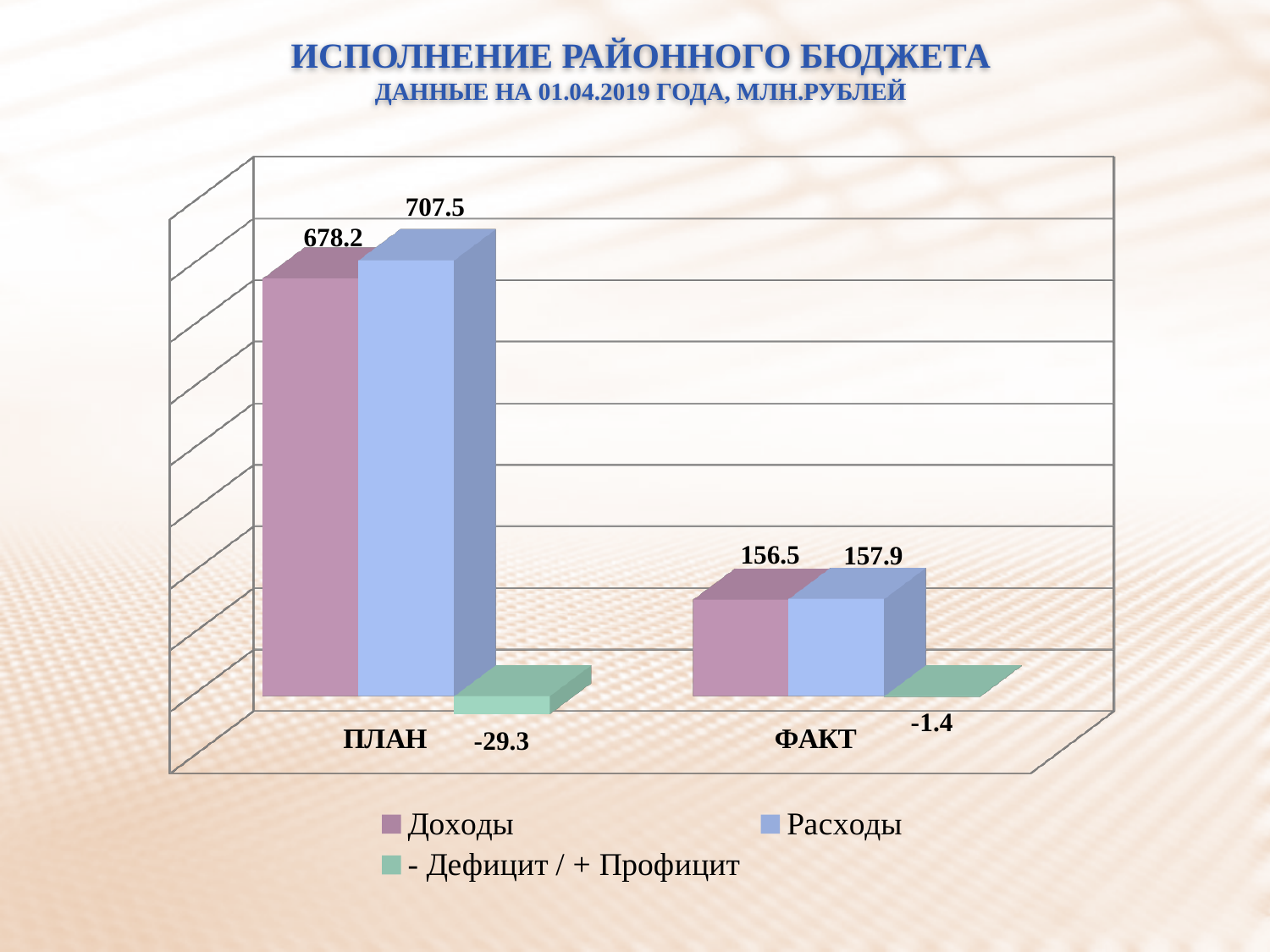
What is the value of Доходы for ПЛАН? 678.2 What is the value of Расходы for ФАКТ? 157.9 Which category has the higher Расходы value, ПЛАН or ФАКТ? ПЛАН What is the value of Доходы for ФАКТ? 156.5 How many series does the legend list? 3 What is the difference between Доходы for ПЛАН and Доходы for ФАКТ? 521.7 What kind of chart is shown on the slide? Bar chart What is the value of - Дефицит / + Профицит for ФАКТ? -1.4 What is the difference between Расходы and Доходы for ПЛАН? 29.3 What is the value of Расходы for ПЛАН? 707.5 How many categories are shown on the x axis? 2 What is the value of - Дефицит / + Профицит for ПЛАН? -29.3